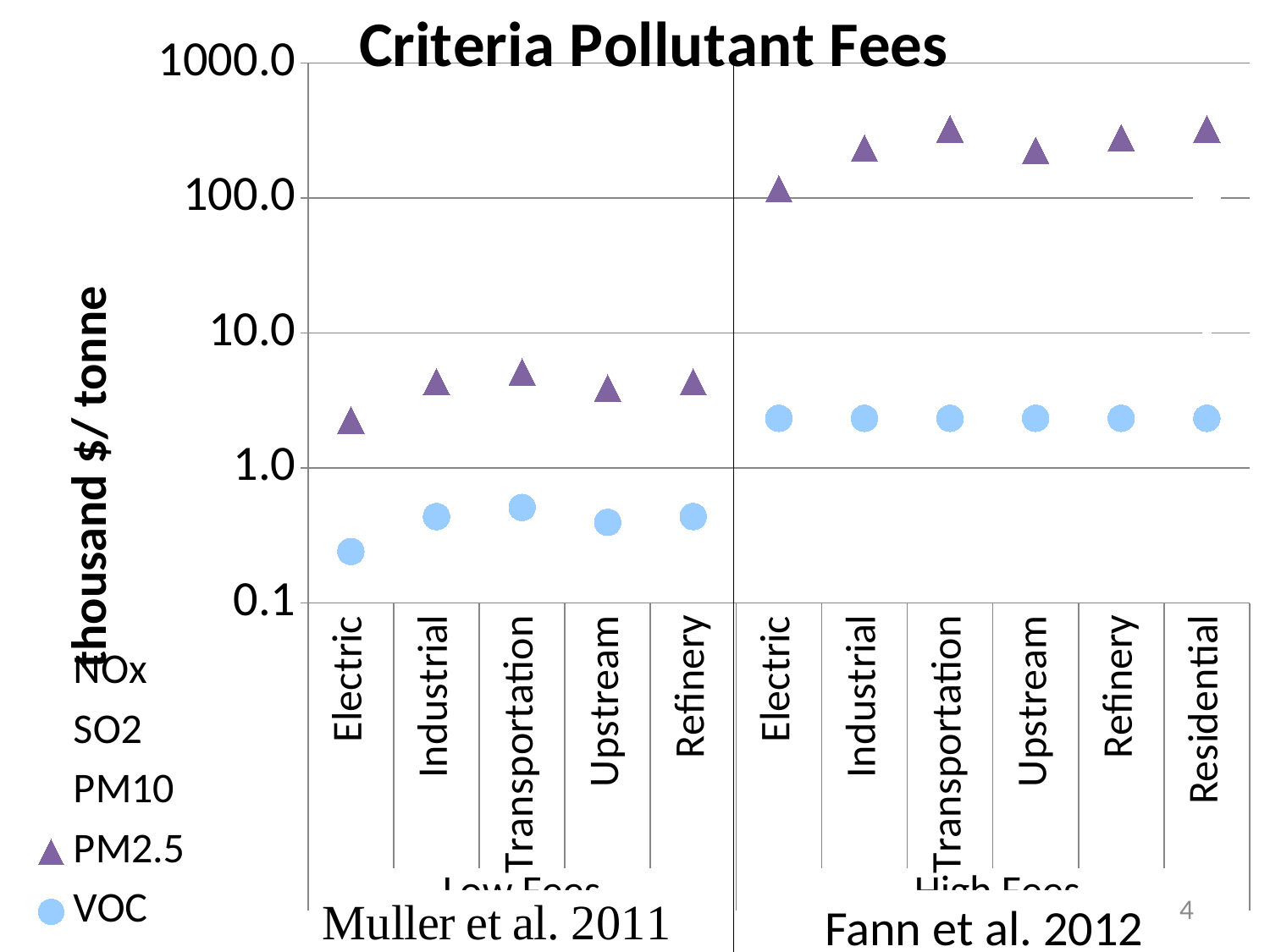
How many categories are plotted in the Low Fees (Muller et al. 2011) group? 5 What is the label on the y axis? thousand $/ tonne Which category has the lowest PM2.5 value in the High Fees group? Electric Which category has the lowest PM2.5 value in the Low Fees group? Electric What is the title of the chart? Criteria Pollutant Fees Is the PM2.5 value for Transportation in the Low Fees group greater or less than 10.0? less For Residential in the High Fees group, which is larger, the PM2.5 value or the VOC value? PM2.5 How many categories are plotted in the High Fees (Fann et al. 2012) group? 6 How many series does the legend list? 5 Is the VOC value for Electric in the Low Fees group greater or less than 1.0? less Is the PM2.5 value for Industrial in the High Fees group greater or less than 100.0? greater What kind of chart is shown on the slide? scatter chart